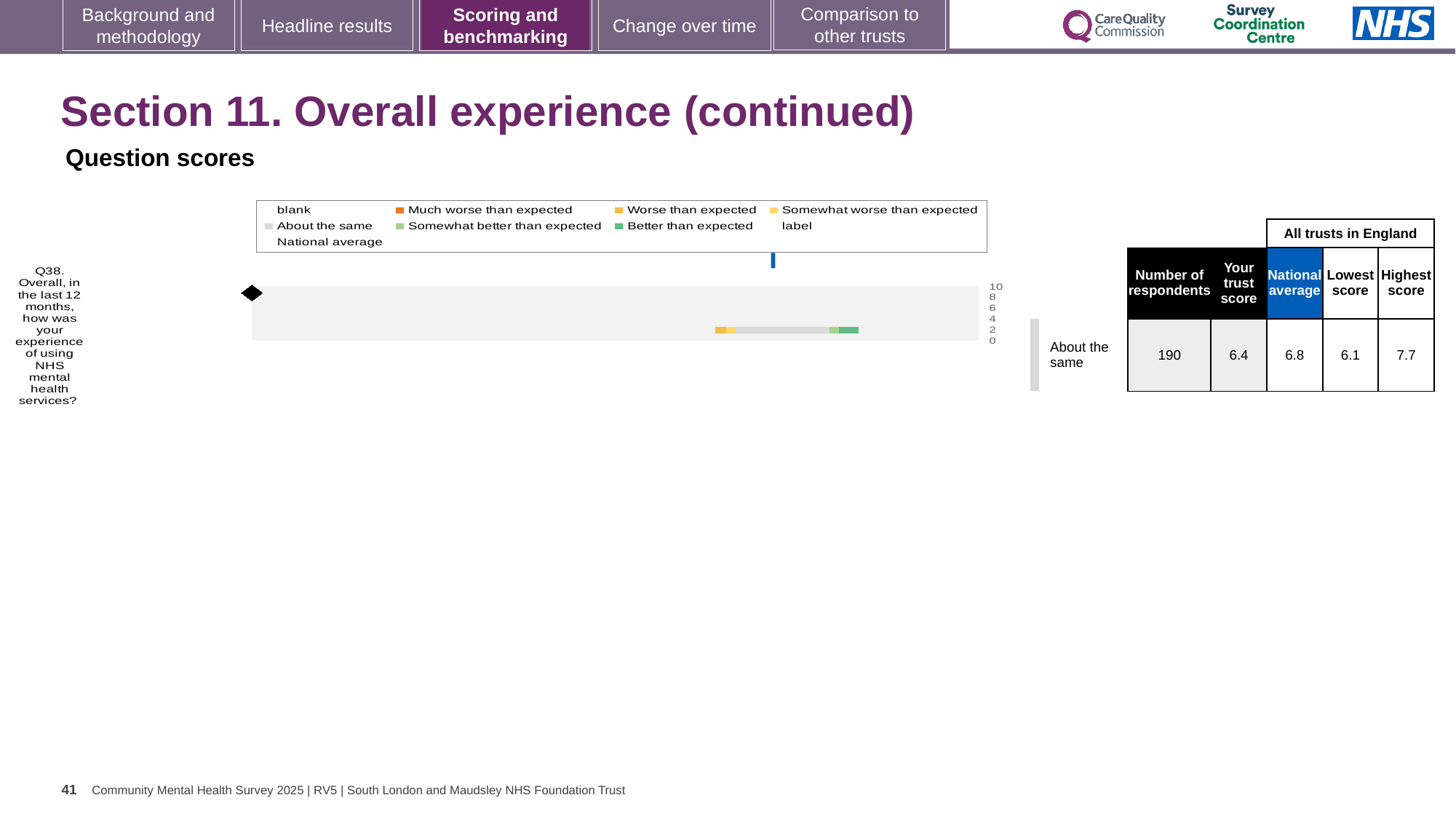
Which is larger for Q38, the trust score or the national average? national average How many questions (categories) are plotted in the chart? 1 What is the trust score for Q38 shown in the table next to the chart? 6.4 What kind of chart is used to show the Q38 question score? bar chart What is the highest score among all trusts in England for Q38? 7.7 What is the difference between the national average and the trust score for Q38? 0.4 What is the lowest score among all trusts in England for Q38? 6.1 How many respondents answered Q38? 190 What is the maximum value shown on the chart's score axis? 10 What is the national average score for Q38? 6.8 What benchmarking category is the trust's Q38 score placed in? About the same What is the difference between the highest and lowest scores for Q38 across all trusts in England? 1.6